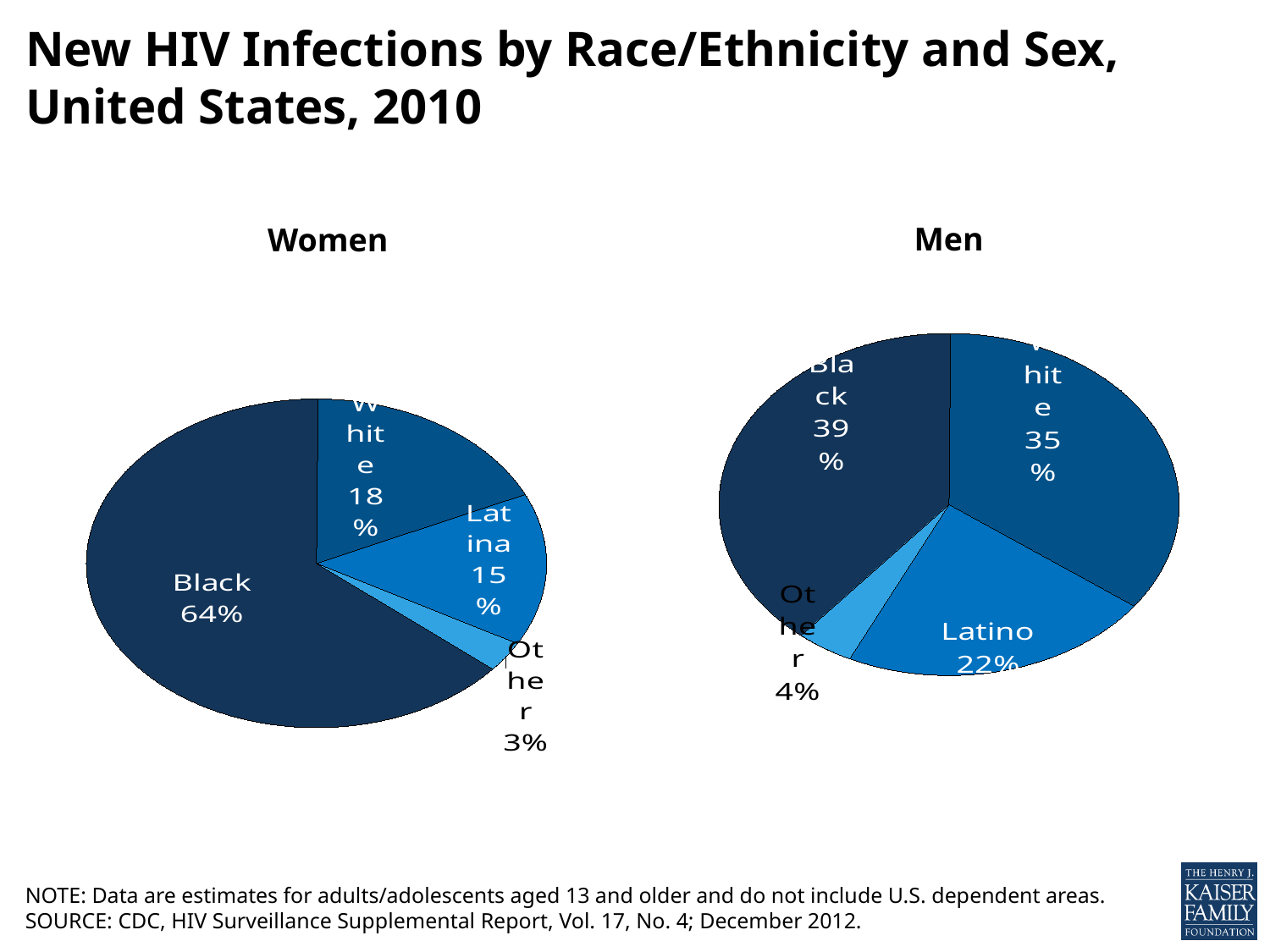
What kind of chart is used for the Men data? Pie chart In the Men chart, what share of new HIV infections is Latino? 22% Which is larger: the Black share in the Women chart or the Black share in the Men chart? Women In the Women chart, what is the difference between the Black and White shares? 46 percentage points In the Women chart, what share is Latina? 15% In the Men chart, which category has the smallest share? Other In the Women chart, what share of new HIV infections is Black? 64% In the Women chart, which category has the largest share? Black How many categories does the Women chart show? 4 What is the title of the slide? New HIV Infections by Race/Ethnicity and Sex, United States, 2010 In the Men chart, what share is White? 35% In the Men chart, what is the difference between the Black and White shares? 4 percentage points